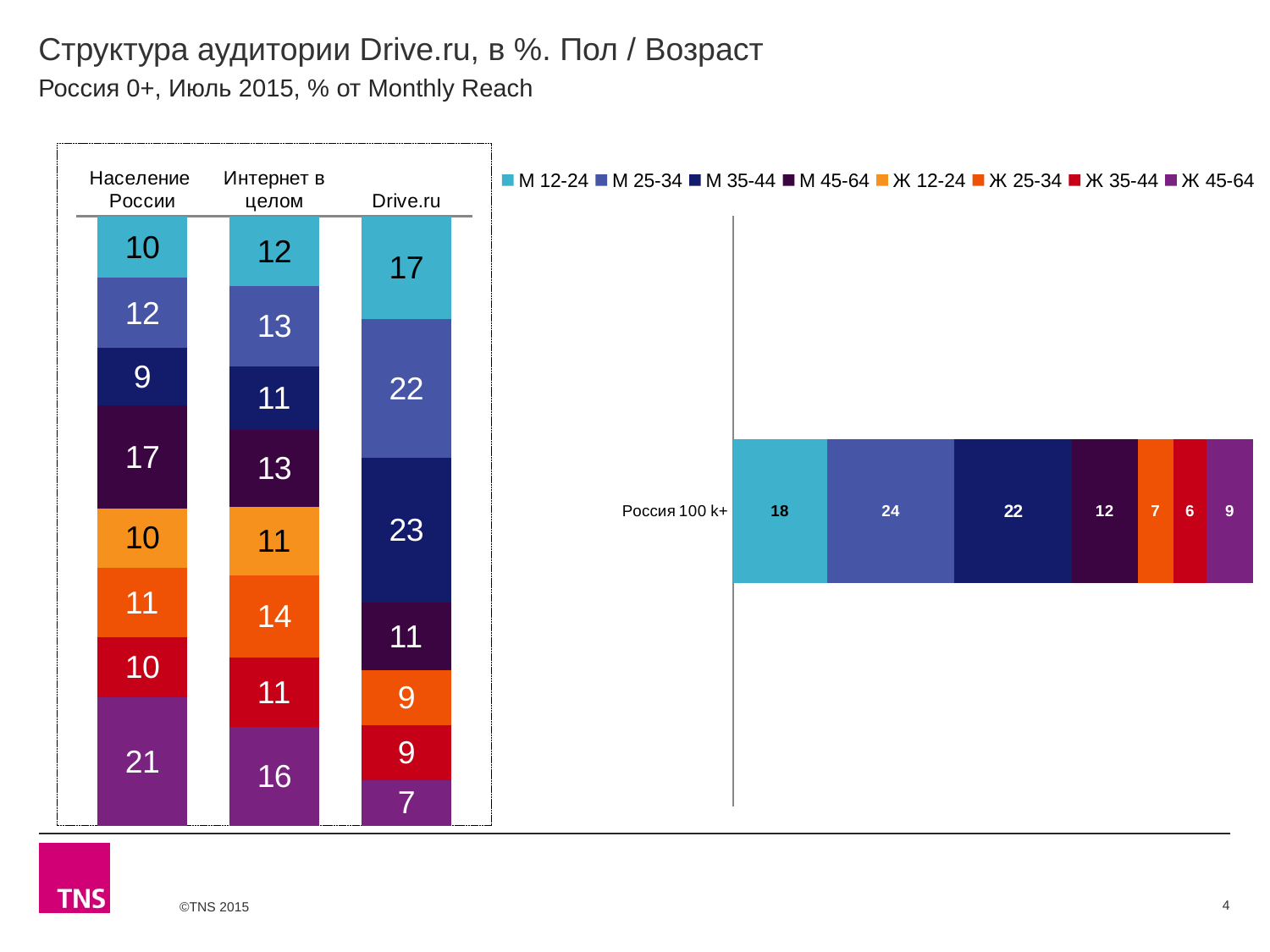
In the right chart (Россия 100 k+), what is the value for Ж 35-44? 6 In the left chart, which has the larger М 35-44 value: Drive.ru or Интернет в целом? Drive.ru How many bars are shown in the left chart? 3 In the left chart, what is the value for Ж 45-64 in the Интернет в целом bar? 16 In the left chart, which segment of the Drive.ru bar has the smallest value? Ж 45-64 In the left chart, what is the value for М 45-64 in the Население России bar? 17 How many series does the legend list? 8 In the right chart (Россия 100 k+), what is the value for М 25-34? 24 In the right chart (Россия 100 k+), which segment has the largest value? М 25-34 In the left chart, what is the difference between the Ж 45-64 values for Население России and Drive.ru? 14 In the right chart (Россия 100 k+), which segment has the smallest value? Ж 35-44 In the left chart, what is the value for М 35-44 in the Drive.ru bar? 23